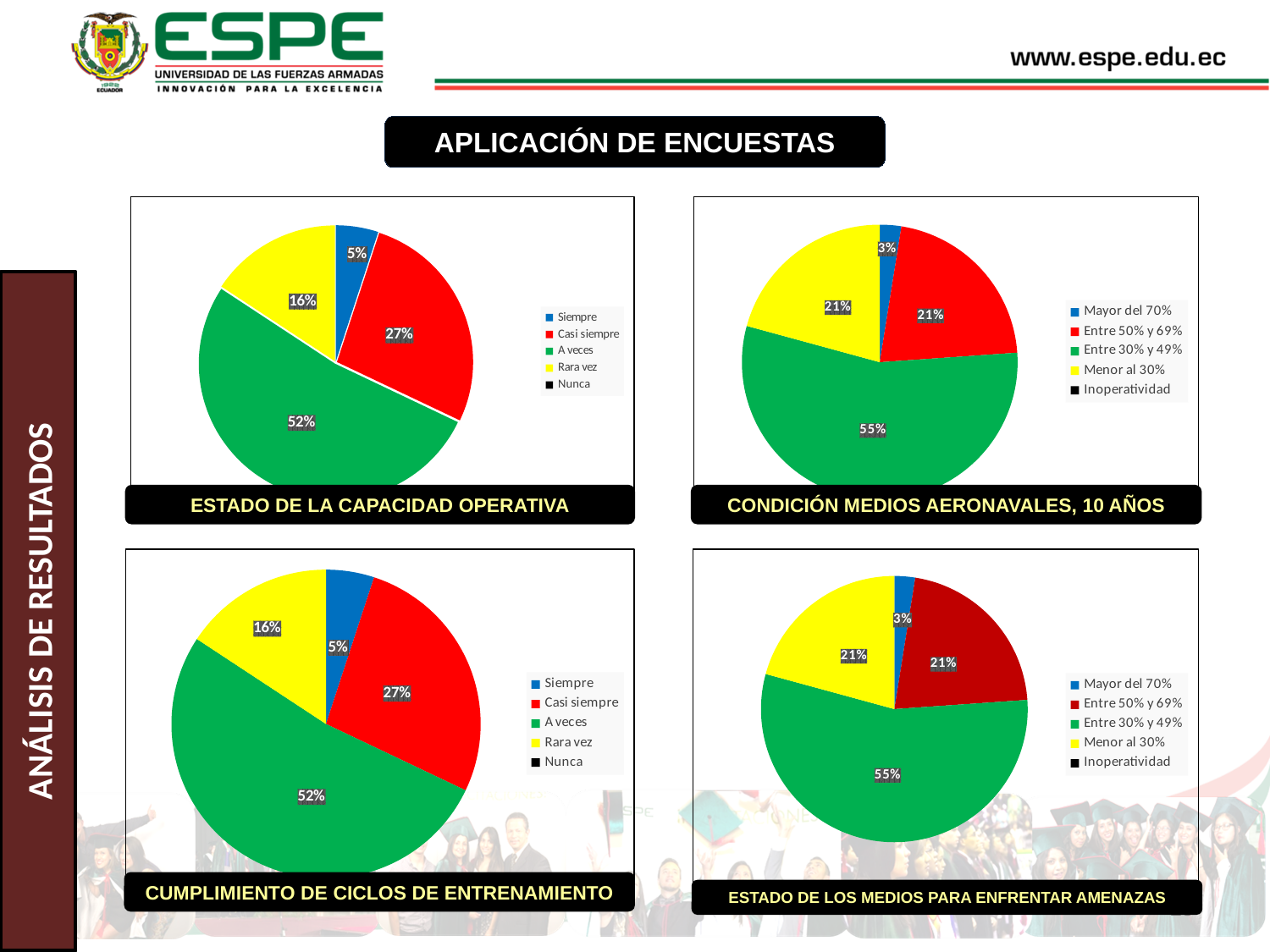
What type of chart is the chart titled CUMPLIMIENTO DE CICLOS DE ENTRENAMIENTO? Pie chart In the chart titled ESTADO DE LOS MEDIOS PARA ENFRENTAR AMENAZAS, which is larger, the share for Entre 50% y 69% or the share for Mayor del 70%? Entre 50% y 69% In the chart titled ESTADO DE LOS MEDIOS PARA ENFRENTAR AMENAZAS, what percentage is shown for Menor al 30%? 21% In the chart titled CUMPLIMIENTO DE CICLOS DE ENTRENAMIENTO, what is the difference in percentage points between A veces and Casi siempre? 25 In the chart titled ESTADO DE LA CAPACIDAD OPERATIVA, what percentage is shown for Casi siempre? 27% In the chart titled ESTADO DE LA CAPACIDAD OPERATIVA, which labelled category has the smallest share? Siempre In the chart titled CONDICIÓN MEDIOS AERONAVALES, 10 AÑOS, what percentage is shown for Mayor del 70%? 3% In the chart titled CUMPLIMIENTO DE CICLOS DE ENTRENAMIENTO, what percentage is shown for Rara vez? 16% How many entries does the legend list in the chart titled ESTADO DE LOS MEDIOS PARA ENFRENTAR AMENAZAS? 5 In the chart titled CONDICIÓN MEDIOS AERONAVALES, 10 AÑOS, which category has the largest share? Entre 30% y 49% In the chart titled ESTADO DE LA CAPACIDAD OPERATIVA, what percentage is shown for A veces? 52% In the chart titled CONDICIÓN MEDIOS AERONAVALES, 10 AÑOS, what percentage is shown for Entre 30% y 49%? 55%